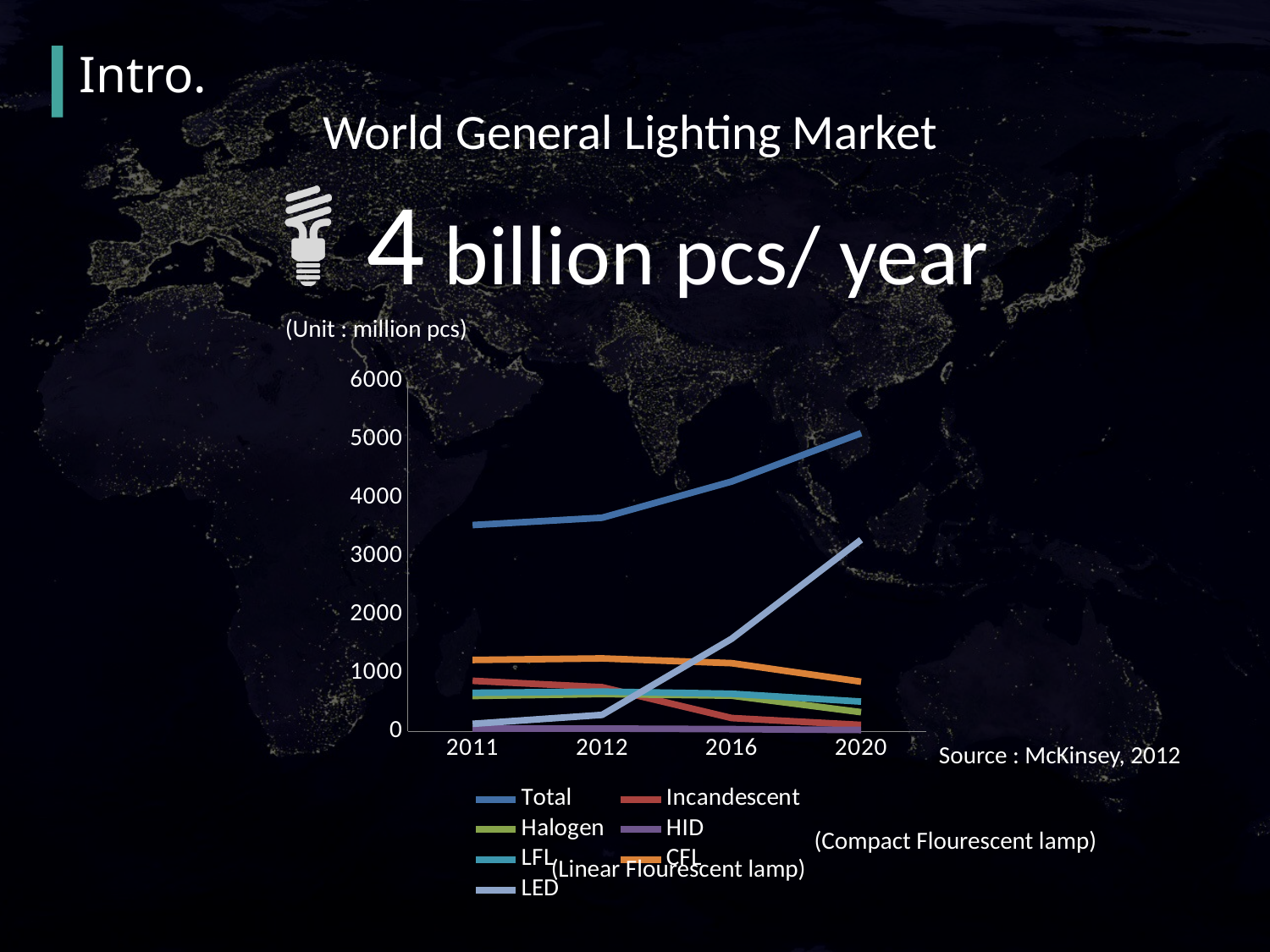
How many series does the legend list? 7 In 2020, which is larger, LED or CFL? LED How many years are shown on the x axis? 4 Does the Total line rise or fall from 2011 to 2020? rise What kind of chart is shown on the slide? line chart What unit is stated for the chart values? million pcs Is the value for Total in 2020 greater or less than 4000? greater Does the Incandescent line rise or fall from 2011 to 2020? fall Is the value for LED in 2011 greater or less than 1000? less Is the value for LED in 2020 greater or less than 2000? greater Which series has the highest value in 2020? Total